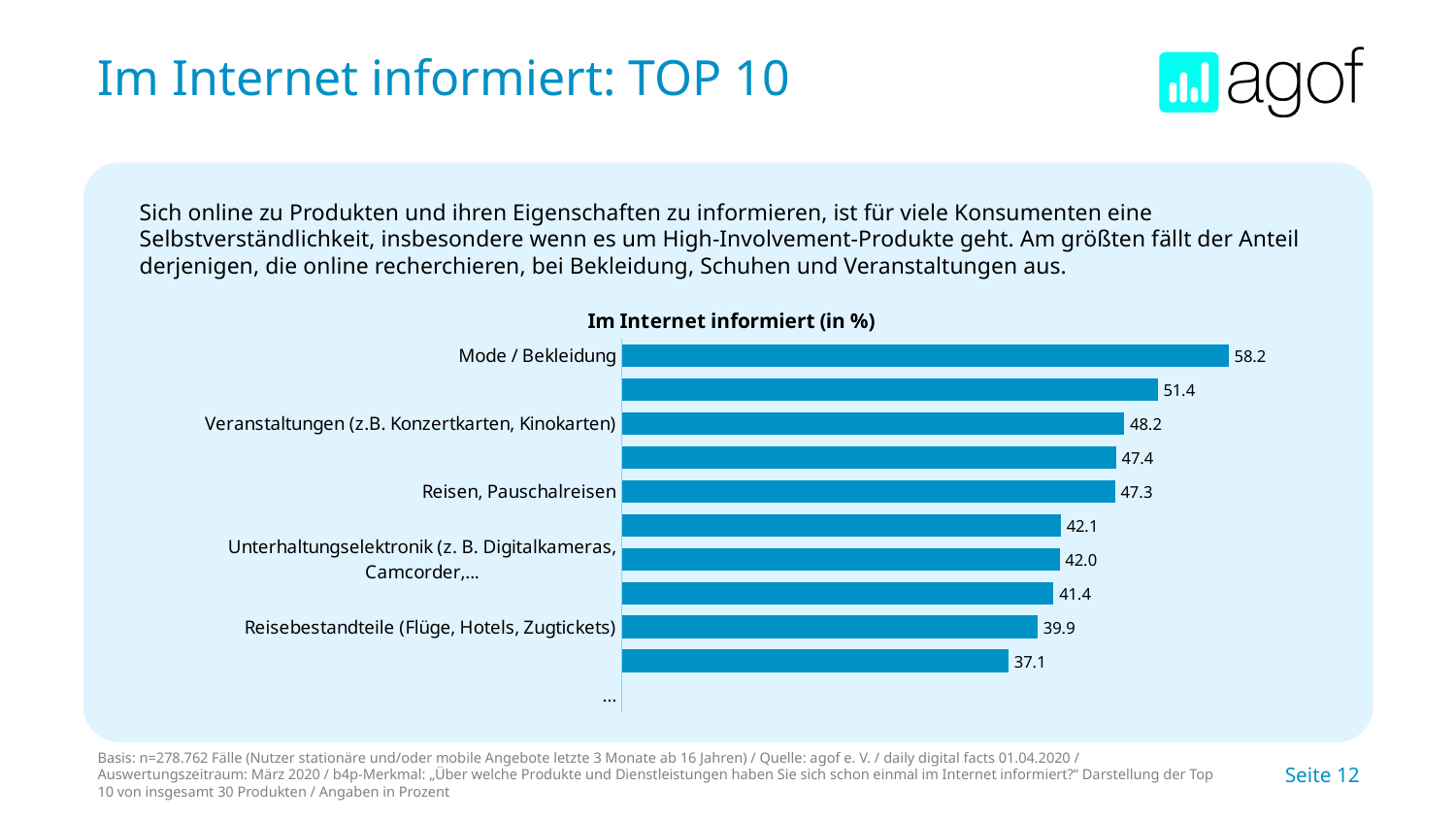
What is the value for Reisen, Pauschalreisen? 47.3 What is the value for Reisebestandteile (Flüge, Hotels, Zugtickets)? 39.9 How many bars with values are shown in the chart? 10 Which has a larger value: Reisen, Pauschalreisen or Reisebestandteile (Flüge, Hotels, Zugtickets)? Reisen, Pauschalreisen What is the value for Veranstaltungen (z.B. Konzertkarten, Kinokarten)? 48.2 What is the value for Mode / Bekleidung? 58.2 What kind of chart is shown on the slide? Bar chart What is the difference between the values for Reisen, Pauschalreisen and Unterhaltungselektronik (z. B. Digitalkameras, Camcorder,...)? 5.3 What is the lowest value shown on any bar in the chart? 37.1 Which category has the highest value in the chart? Mode / Bekleidung What is the value for Unterhaltungselektronik (z. B. Digitalkameras, Camcorder,...)? 42.0 What is the difference between the values for Mode / Bekleidung and Veranstaltungen (z.B. Konzertkarten, Kinokarten)? 10.0